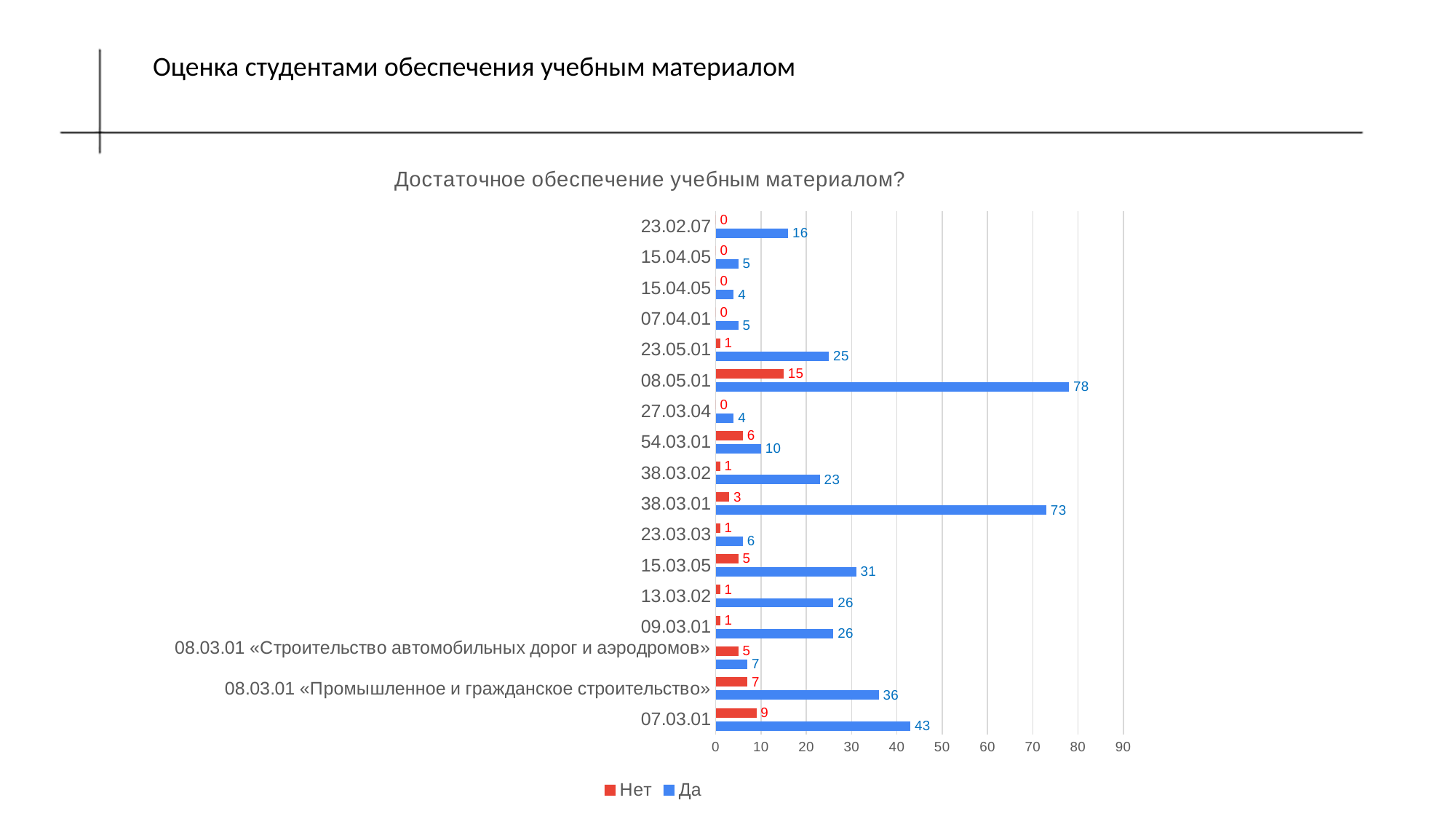
How many series does the legend list? 2 Is the Да value for 38.03.02 greater or less than 20? greater What is the value of the Да series for 08.05.01? 78 Which category has the highest Нет value? 08.05.01 What is the value of the Да series for 08.03.01 «Промышленное и гражданское строительство»? 36 What is the total of the Да and Нет values for 07.03.01? 52 What is the difference between the Да and Нет values for 38.03.01? 70 Which category has the highest Да value? 08.05.01 What kind of chart is shown on the slide? bar chart Which has the larger Да value, 15.03.05 or 23.05.01? 15.03.05 How many categories are shown on the y axis of the chart? 17 What is the value of the Нет series for 07.03.01? 9